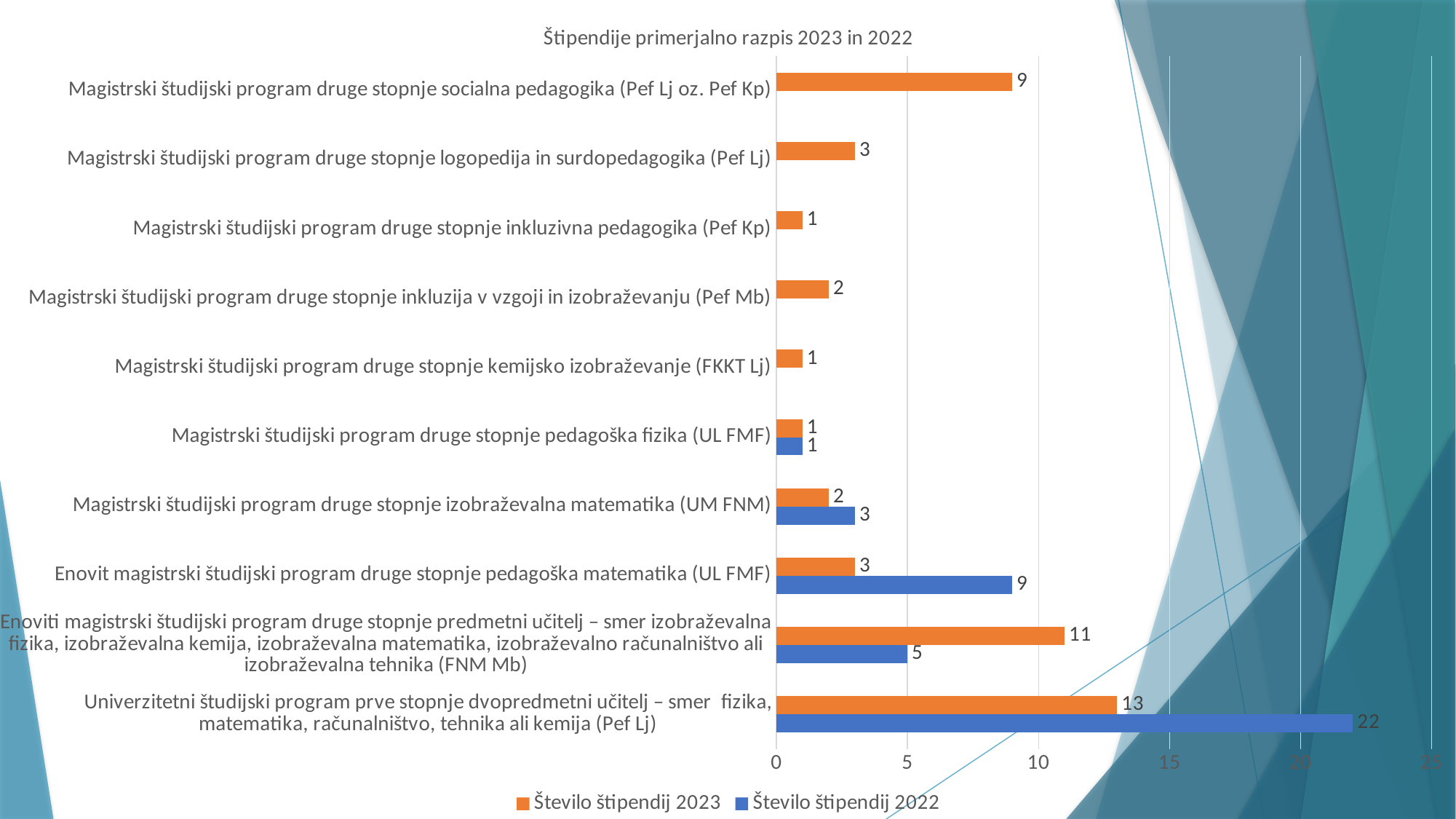
What is the value of Število štipendij 2023 for the Enoviti magistrski študijski program druge stopnje predmetni učitelj (FNM Mb)? 11 What is the value of Število štipendij 2023 for Magistrski študijski program druge stopnje socialna pedagogika (Pef Lj oz. Pef Kp)? 9 What is the value of Število štipendij 2022 for the Univerzitetni študijski program prve stopnje dvopredmetni učitelj (Pef Lj)? 22 How many study programs (categories) are shown on the chart? 10 What is the difference between Število štipendij 2022 and Število štipendij 2023 for the Univerzitetni študijski program prve stopnje dvopredmetni učitelj (Pef Lj)? 9 How many series does the legend list? 2 What is the value of Število štipendij 2022 for Magistrski študijski program druge stopnje izobraževalna matematika (UM FNM)? 3 Which category has the highest value for Število štipendij 2022? Univerzitetni študijski program prve stopnje dvopredmetni učitelj – smer fizika, matematika, računalništvo, tehnika ali kemija (Pef Lj) What is the title of the chart? Štipendije primerjalno razpis 2023 in 2022 What type of chart is shown on the slide? bar chart Which colour represents Število štipendij 2023 in the chart? orange For Enovit magistrski študijski program druge stopnje pedagoška matematika (UL FMF), which is larger: Število štipendij 2023 or Število štipendij 2022? Število štipendij 2022